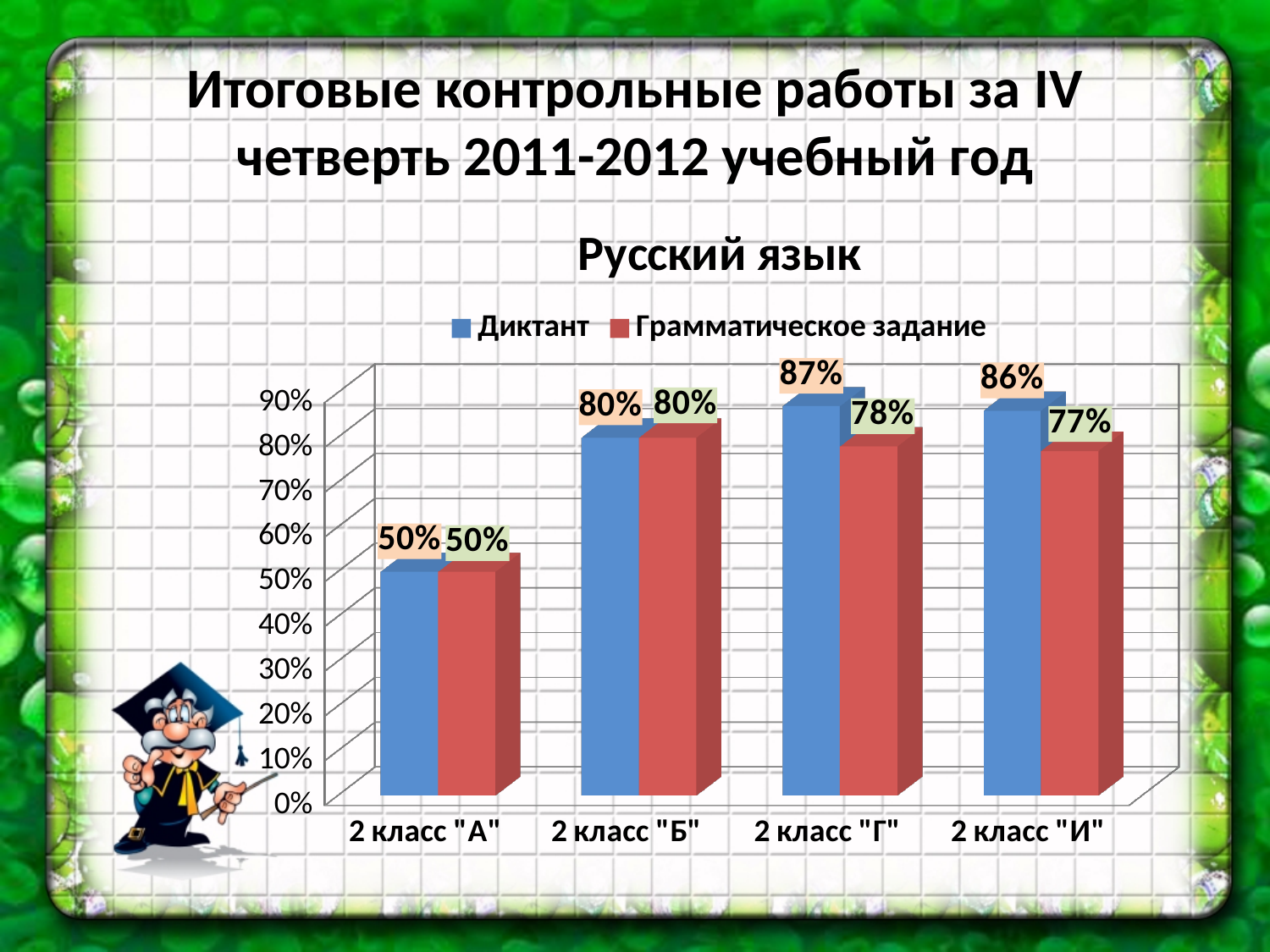
What is the title of the chart? Русский язык What is the difference between the Диктант and Грамматическое задание values for 2 класс "Г"? 9% How many series does the legend list? 2 What is the Грамматическое задание value for 2 класс "И"? 77% Which is larger: the Диктант value for 2 класс "Б" or the Диктант value for 2 класс "И"? 2 класс "И" What is the Диктант value for 2 класс "А"? 50% What is the Диктант value for 2 класс "Г"? 87% Which colour represents Грамматическое задание in the legend? red How many classes are shown on the x axis? 4 Which class has the highest Диктант value? 2 класс "Г" What kind of chart is shown? bar chart Which class has the lowest Грамматическое задание value? 2 класс "А"